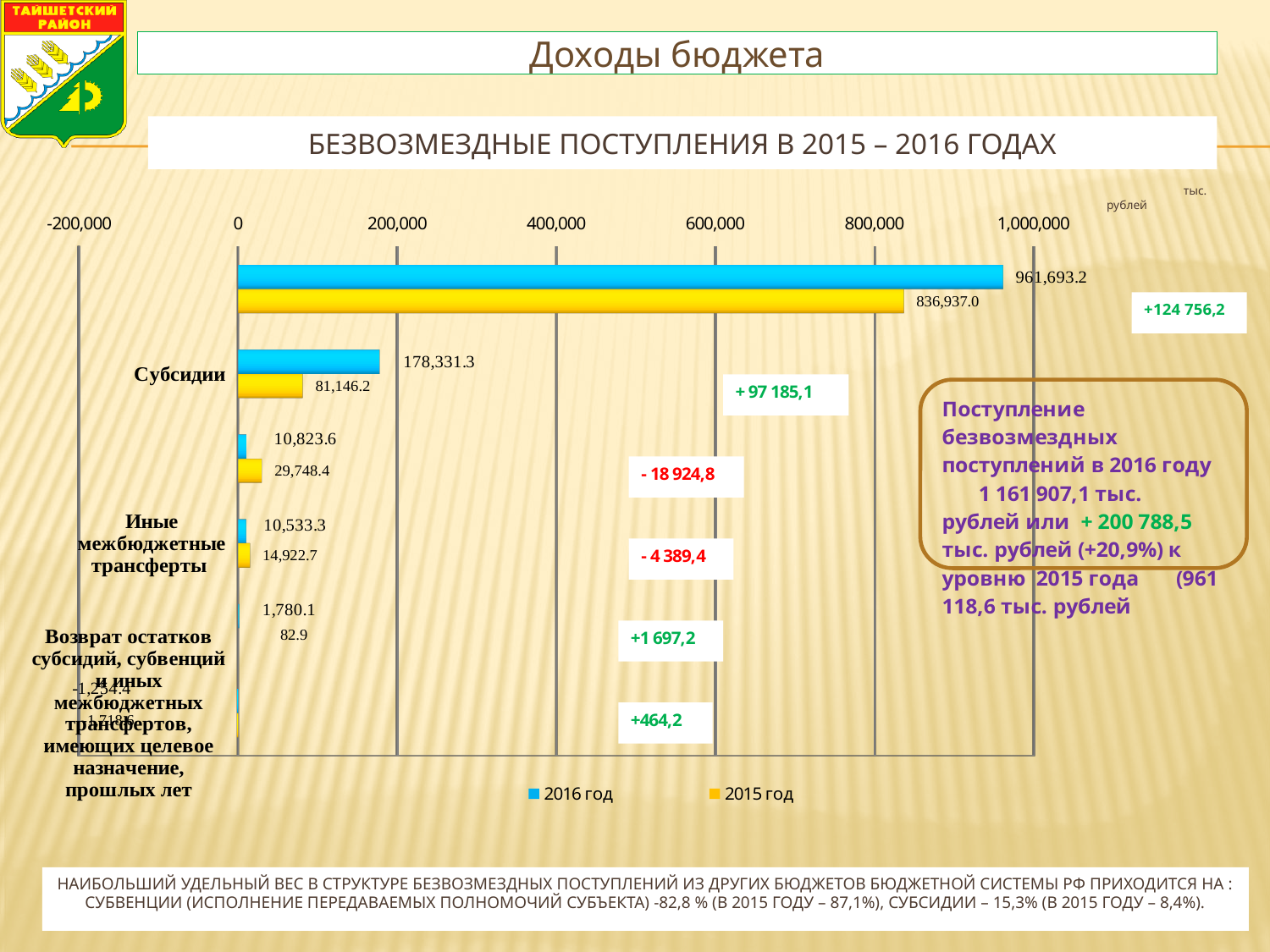
What are the two series named in the chart legend? 2016 год and 2015 год What is the value for Иные межбюджетные трансферты in the 2015 год series? 14,922.7 What is the difference between the 2016 год and 2015 год values for Субсидии? 97,185.1 What is the value for Возврат остатков субсидий, субвенций и иных межбюджетных трансфертов in the 2016 год series? -1,254.4 What is the value for Иные межбюджетные трансферты in the 2016 год series? 10,533.3 Is the 2016 год value for Субсидии greater or less than 200,000? less How many series does the chart legend list? 2 What is the largest value labelled on the chart? 961,693.2 What type of chart is shown on the slide? bar chart What is the value for Субсидии in the 2016 год series? 178,331.3 For Субсидии, which series has the larger value, 2016 год or 2015 год? 2016 год What is the value for Субсидии in the 2015 год series? 81,146.2